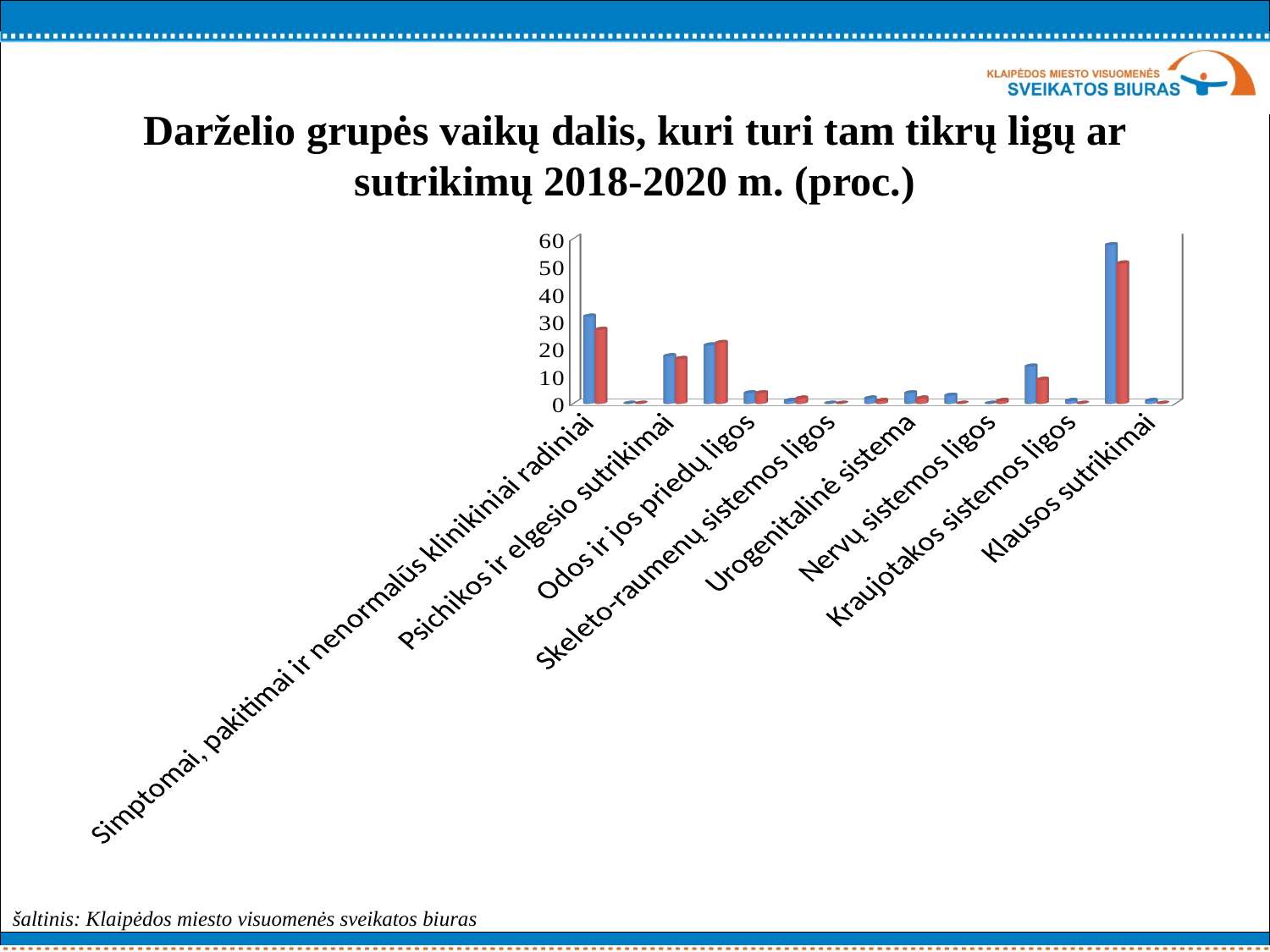
What kind of chart is shown on the slide? bar chart Is the red bar for Simptomai, pakitimai ir nenormalūs klinikiniai radiniai greater or less than 40? less What is the title of the chart on the slide? Darželio grupės vaikų dalis, kuri turi tam tikrų ligų ar sutrikimų 2018-2020 m. (proc.) Is the blue bar for Psichikos ir elgesio sutrikimai greater or less than 30? less Is the blue bar for Simptomai, pakitimai ir nenormalūs klinikiniai radiniai greater or less than 20? greater